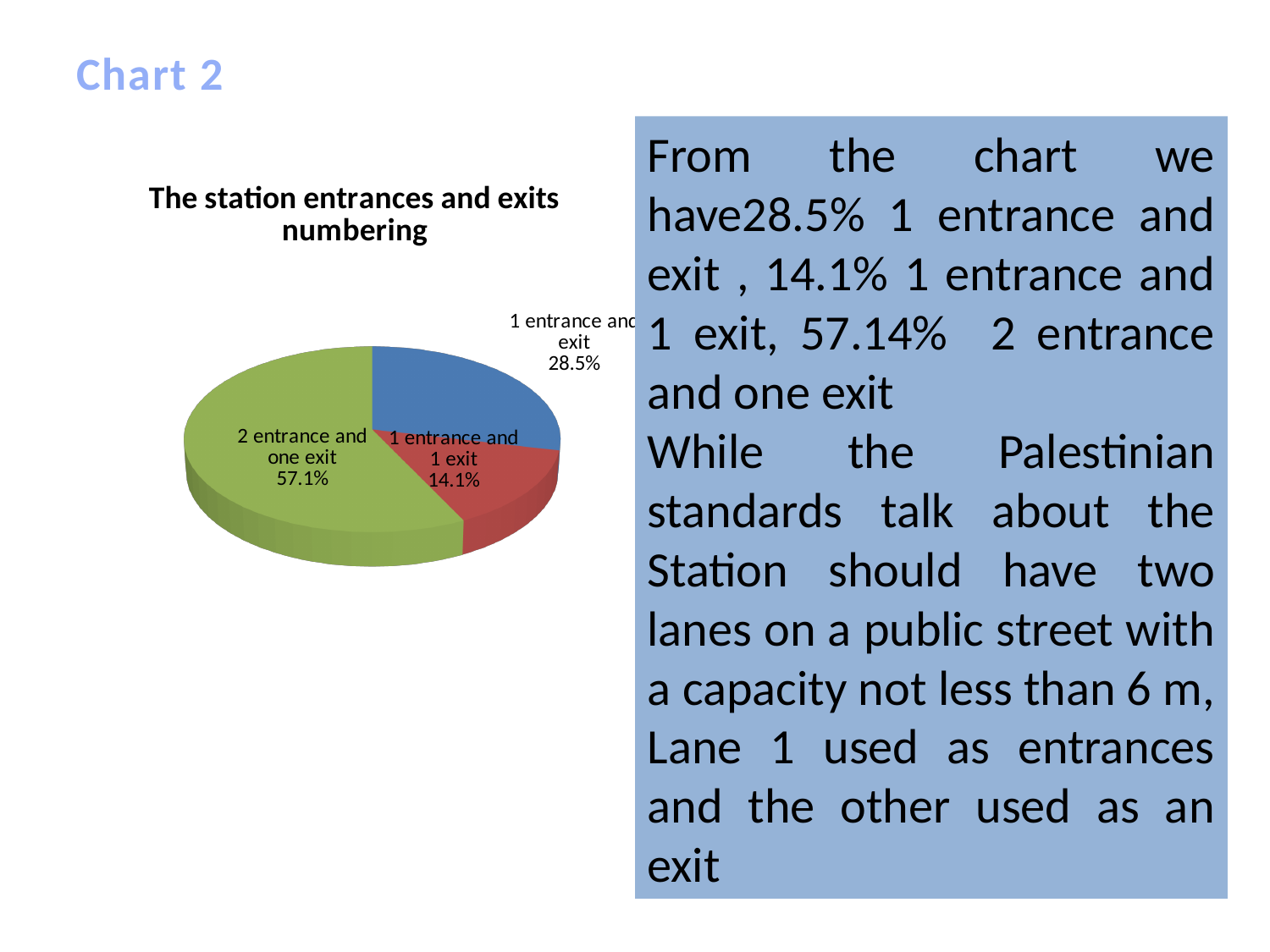
What is the title of the pie chart? The station entrances and exits numbering What colour is the slice for "2 entrance and one exit"? green Which category has the smallest slice of the pie? 1 entrance and 1 exit Which category has the largest slice of the pie? 2 entrance and one exit How many slices does the pie chart have? 3 What share of the pie does "2 entrance and one exit" have? 57.1% What is the difference in percentage points between the "1 entrance and exit" slice and the "1 entrance and 1 exit" slice? 14.4 What share of the pie does "1 entrance and exit" have? 28.5% What share of the pie does "1 entrance and 1 exit" have? 14.1% What kind of chart is shown on the slide? pie chart What is the difference in percentage points between the "2 entrance and one exit" slice and the "1 entrance and exit" slice? 28.6 Which is larger: the slice for "1 entrance and exit" or the slice for "1 entrance and 1 exit"? 1 entrance and exit